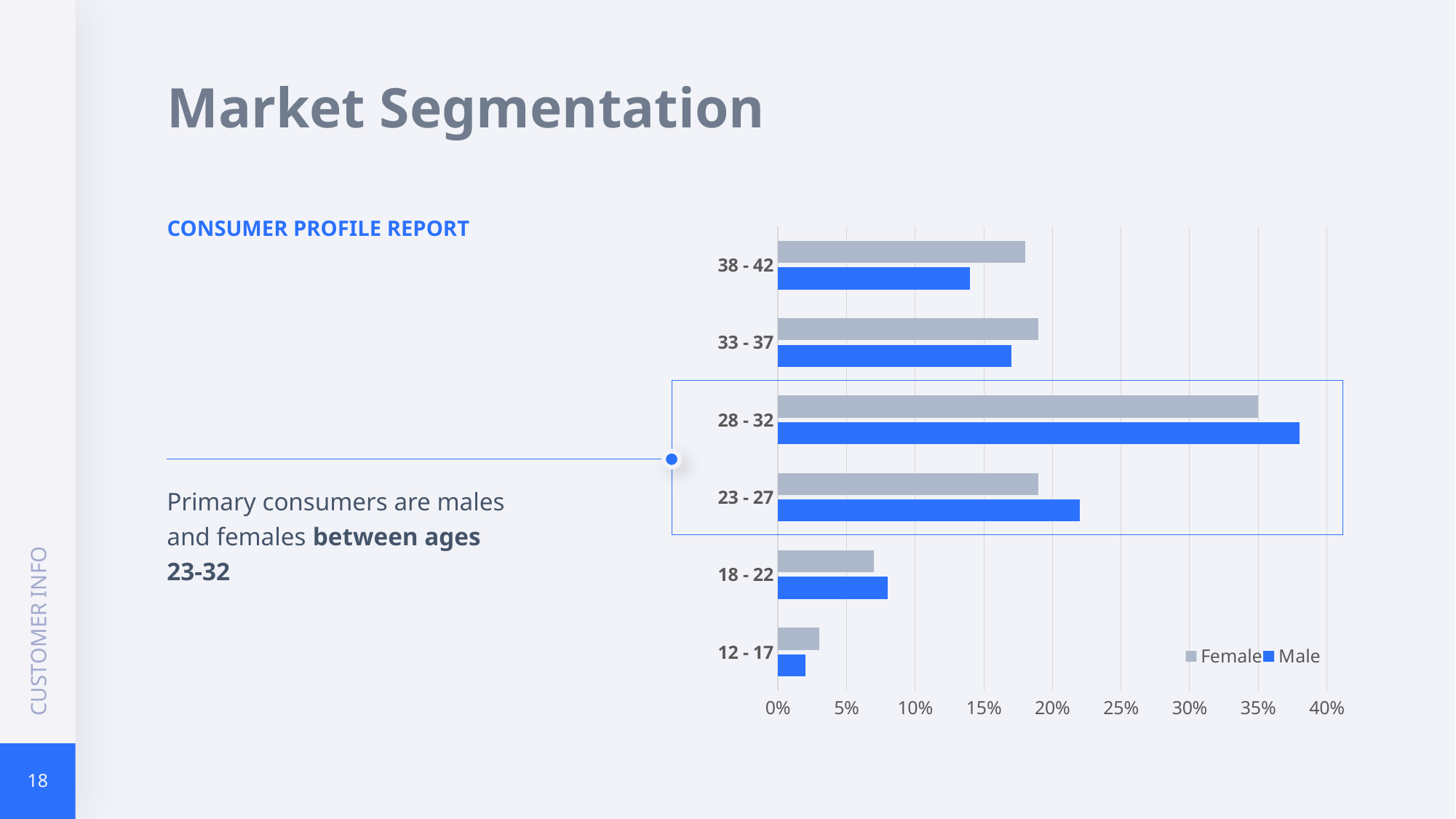
Which age group has the highest Male value? 28 - 32 Is the Male value for the 28 - 32 age group greater or less than 35%? greater Which age group has the lowest Male value? 12 - 17 Which colour represents the Male series in the chart? blue For the 38 - 42 age group, which is larger, the Male or the Female value? Female Which age group has the lowest Female value? 12 - 17 How many age groups are shown on the chart? 6 Which age group has the highest Female value? 28 - 32 How many series does the chart legend list? 2 Is the Female value for the 38 - 42 age group greater or less than 20%? less For the 23 - 27 age group, which is larger, the Male or the Female value? Male What kind of chart is shown on the slide? bar chart